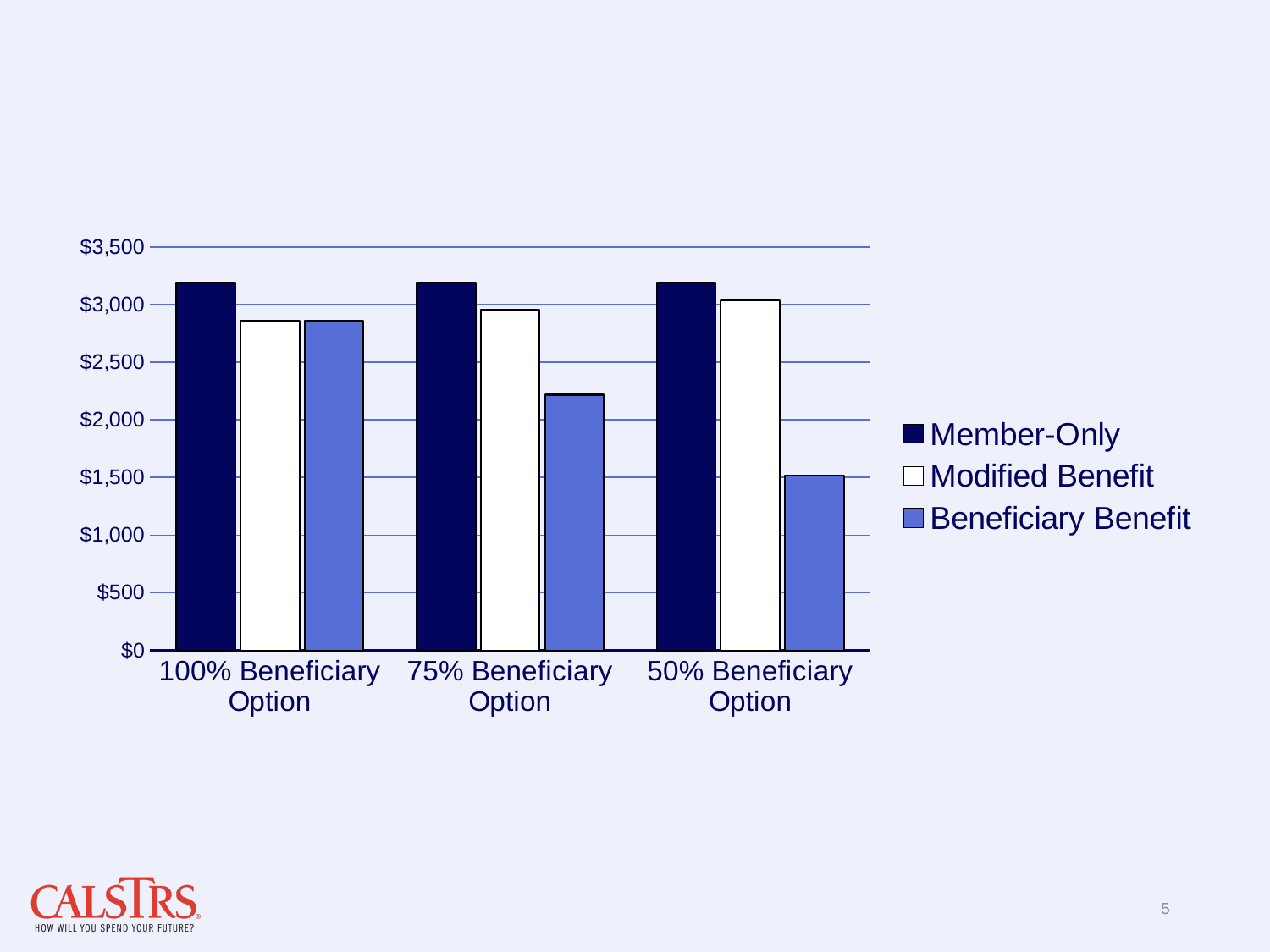
Does the Beneficiary Benefit series rise or fall moving from the 100% Beneficiary Option to the 50% Beneficiary Option? fall For the 75% Beneficiary Option, which is larger: the Modified Benefit value or the Beneficiary Benefit value? Modified Benefit Is the Beneficiary Benefit value for the 75% Beneficiary Option greater or less than $2,000? greater Is the Member-Only value for the 100% Beneficiary Option greater or less than $3,000? greater Is the Beneficiary Benefit value for the 50% Beneficiary Option greater or less than $2,000? less For the 50% Beneficiary Option, which is larger: the Member-Only value or the Beneficiary Benefit value? Member-Only How many categories are shown on the x axis of the chart? 3 What kind of chart is shown on the slide? bar chart How many series does the chart's legend list? 3 Which category has the lowest Beneficiary Benefit value? 50% Beneficiary Option Which series is shown with the dark navy bars in the legend? Member-Only